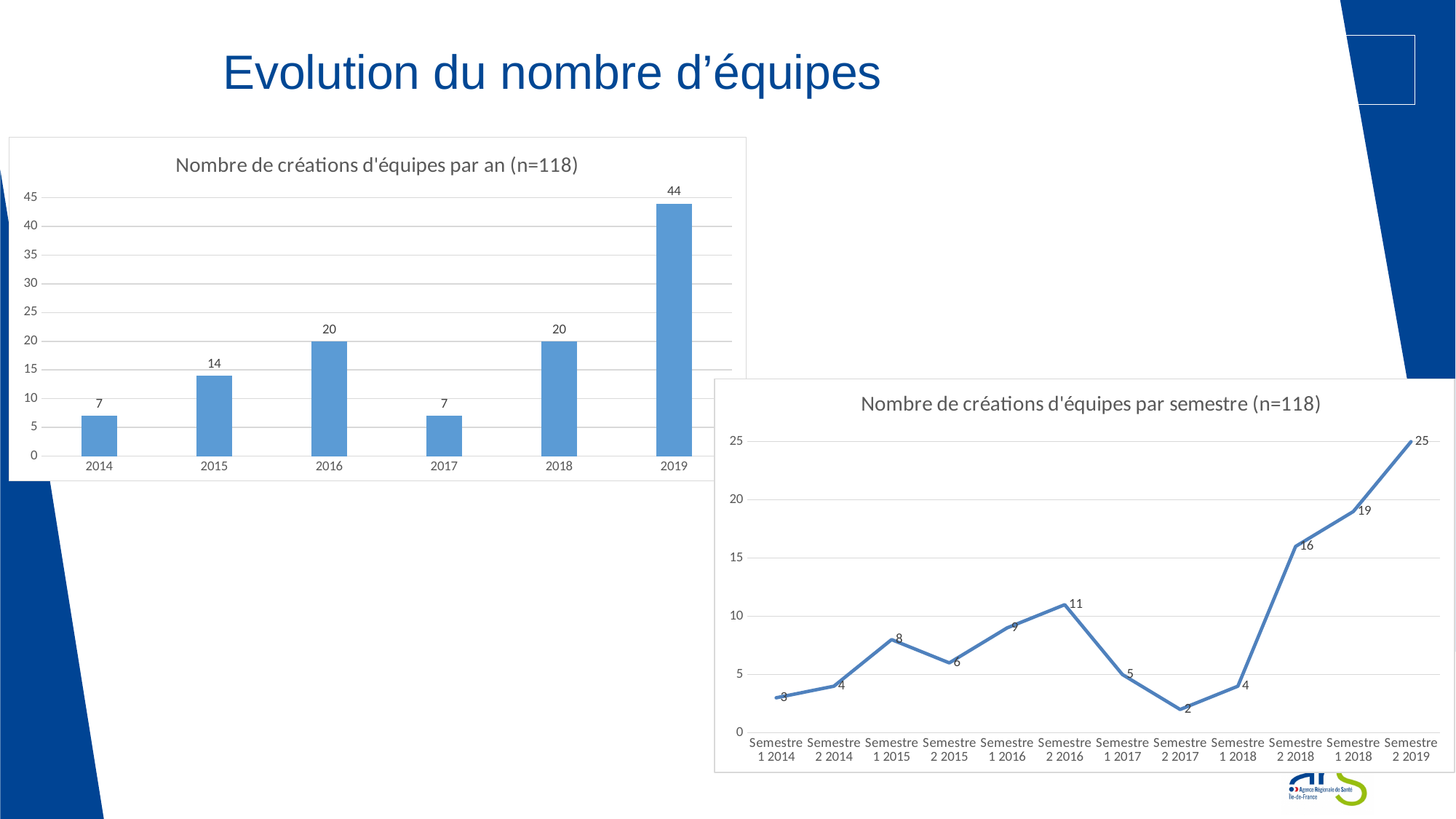
In the chart 'Nombre de créations d'équipes par an (n=118)', how many years are shown on the x axis? 6 In the chart 'Nombre de créations d'équipes par semestre (n=118)', what is the value for Semestre 2 2016? 11 In the chart 'Nombre de créations d'équipes par an (n=118)', what is the difference between the values for 2019 and 2018? 24 What kind of chart is 'Nombre de créations d'équipes par an (n=118)'? Bar chart In the chart 'Nombre de créations d'équipes par an (n=118)', which is larger, the value for 2015 or the value for 2017? 2015 What kind of chart is 'Nombre de créations d'équipes par semestre (n=118)'? Line chart In the chart 'Nombre de créations d'équipes par semestre (n=118)', which semester has the lowest value? Semestre 2 2017 In the chart 'Nombre de créations d'équipes par an (n=118)', which year has the lowest value? 2014 and 2017 In the chart 'Nombre de créations d'équipes par an (n=118)', what is the value for 2019? 44 In the chart 'Nombre de créations d'équipes par semestre (n=118)', how many data points are plotted? 12 In the chart 'Nombre de créations d'équipes par semestre (n=118)', which semester has the highest value? Semestre 2 2019